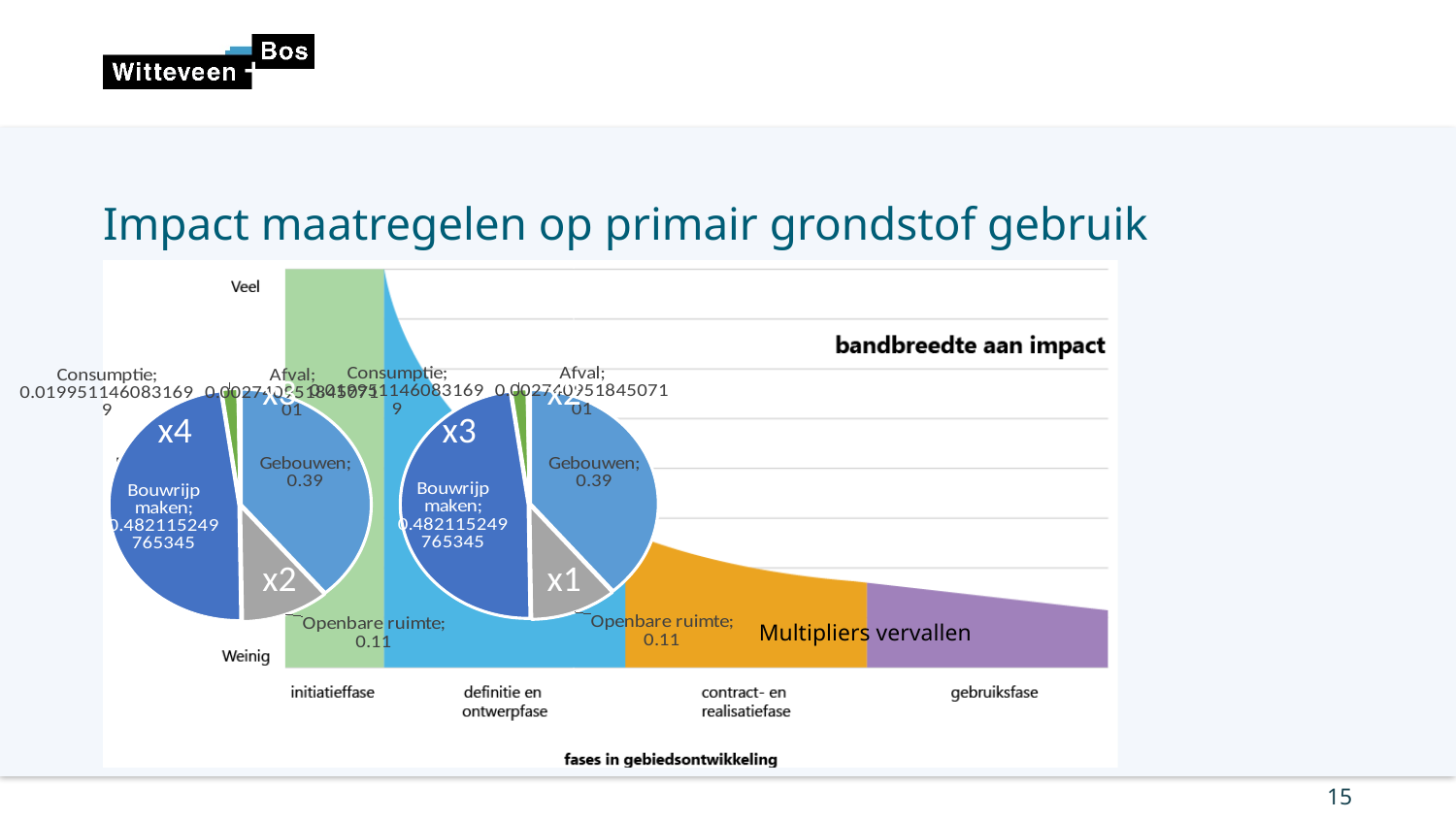
In the left pie chart, what is the value for Gebouwen? 0.39 In the left pie chart, which category has the largest slice? Bouwrijp maken In the background area chart titled 'bandbreedte aan impact', how many phases are listed on the x axis? 4 In the right pie chart, which is larger, Gebouwen or Openbare ruimte? Gebouwen What is the x-axis title of the background area chart? fases in gebiedsontwikkeling In the right pie chart, what is the value for Openbare ruimte? 0.11 In the left pie chart, what is the value for Bouwrijp maken? 0.482115249765345 In the left pie chart, how many slices are labelled? 5 In the background area chart titled 'bandbreedte aan impact', does the plotted area rise or fall from initiatieffase to gebruiksfase? fall In the right pie chart, what is the difference between the values for Gebouwen and Openbare ruimte? 0.28 What is the title shown on the background area chart? bandbreedte aan impact What kind of chart is the left chart with the 'Bouwrijp maken' slice? pie chart